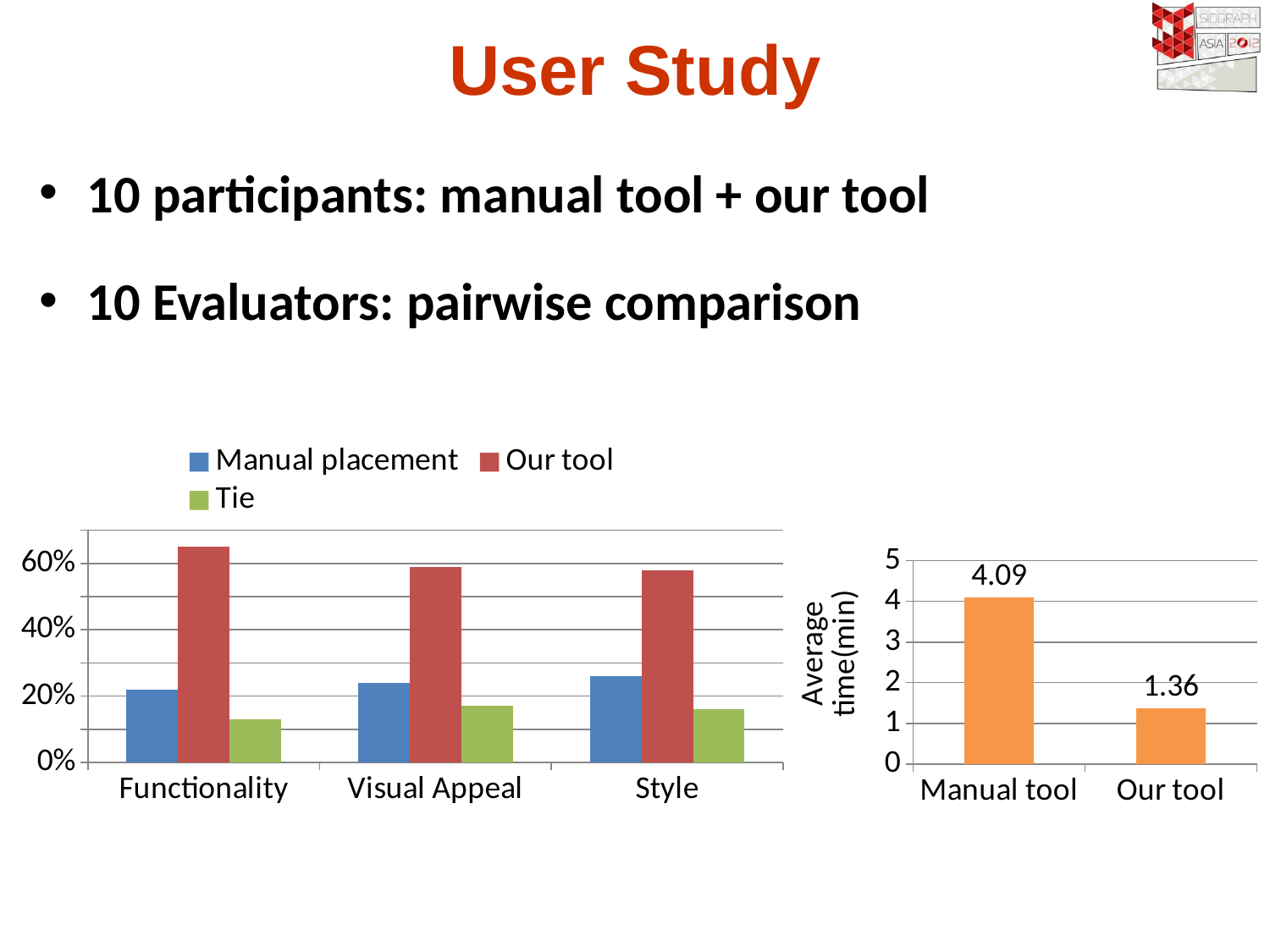
In the right chart, how many categories are shown on the x axis? 2 In the right chart, which tool has the higher average time? Manual tool In the right chart, what is the average time for Our tool? 1.36 In the right chart, what is the average time for the Manual tool? 4.09 In the left chart, is the value of Our tool for Functionality greater or less than 60%? greater In the left chart, how many series does the legend list? 3 In the left chart, which series has the highest value for Functionality? Our tool In the left chart, how many categories are shown on the x axis? 3 What kind of chart is the left chart? bar chart In the right chart, what is the difference in average time between the Manual tool and Our tool? 2.73 In the right chart, what is the label of the vertical axis? Average time(min) In the left chart, is the value of Tie for Functionality greater or less than 20%? less